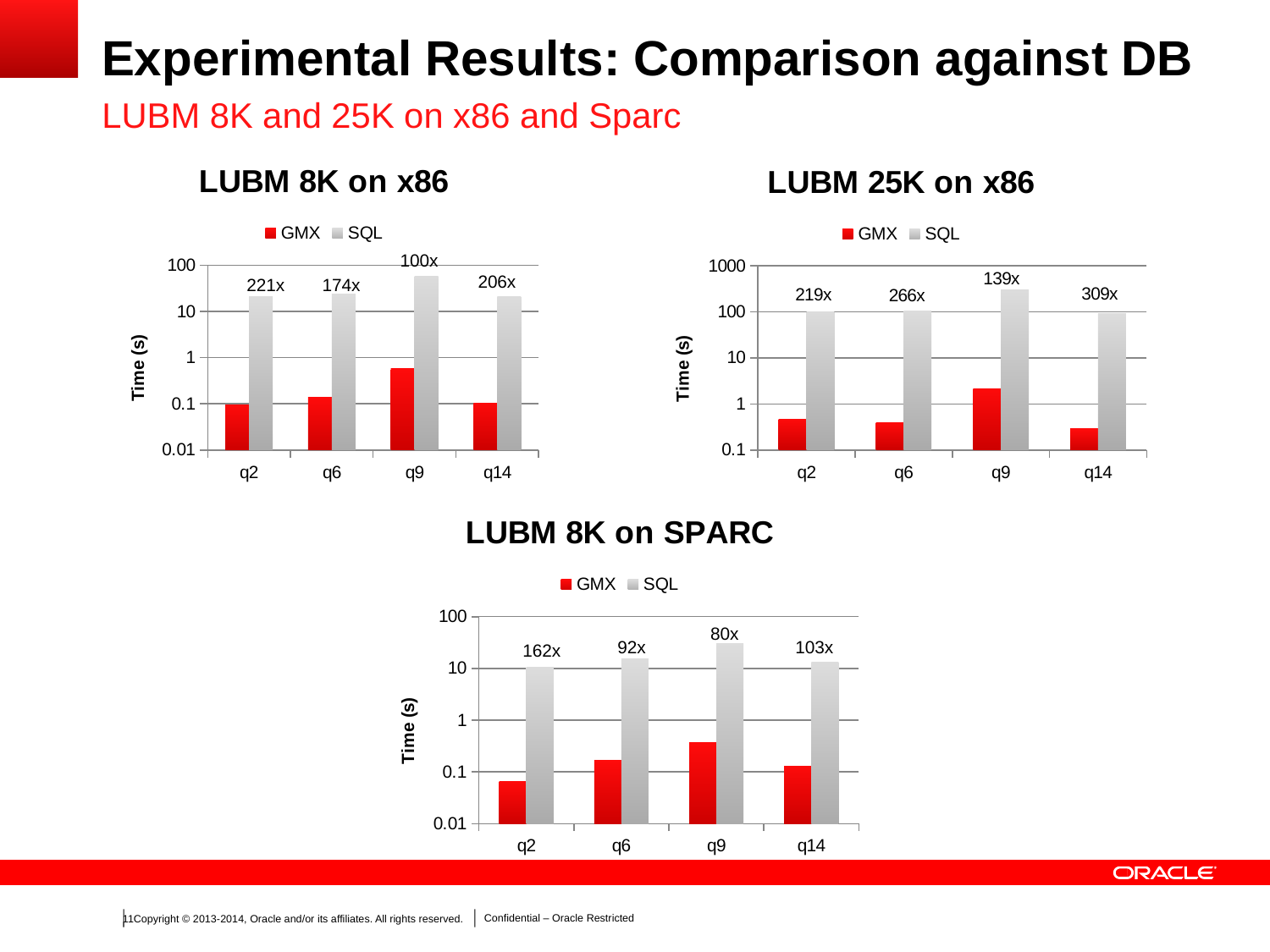
In the LUBM 8K on SPARC chart, is the GMX value for q9 greater or less than 1? less In the LUBM 8K on x86 chart, what speedup label is printed above the SQL bar for q2? 221x In the LUBM 8K on SPARC chart, which is larger for q14, the GMX value or the SQL value? SQL In the LUBM 25K on x86 chart, is the SQL value for q9 greater or less than 100? greater In the LUBM 25K on x86 chart, for which query is the SQL bar highest? q9 In the LUBM 8K on x86 chart, for which query is the GMX bar highest? q9 In the LUBM 25K on x86 chart, what speedup label is printed above the SQL bar for q14? 309x What kind of chart is the LUBM 8K on x86 chart? Bar chart How many series does the legend of the LUBM 8K on SPARC chart list? 2 How many queries are shown on the x axis of the LUBM 25K on x86 chart? 4 In the LUBM 8K on SPARC chart, what speedup label is printed above the SQL bar for q9? 80x In the LUBM 8K on x86 chart, is the SQL value for q9 greater or less than 10? greater